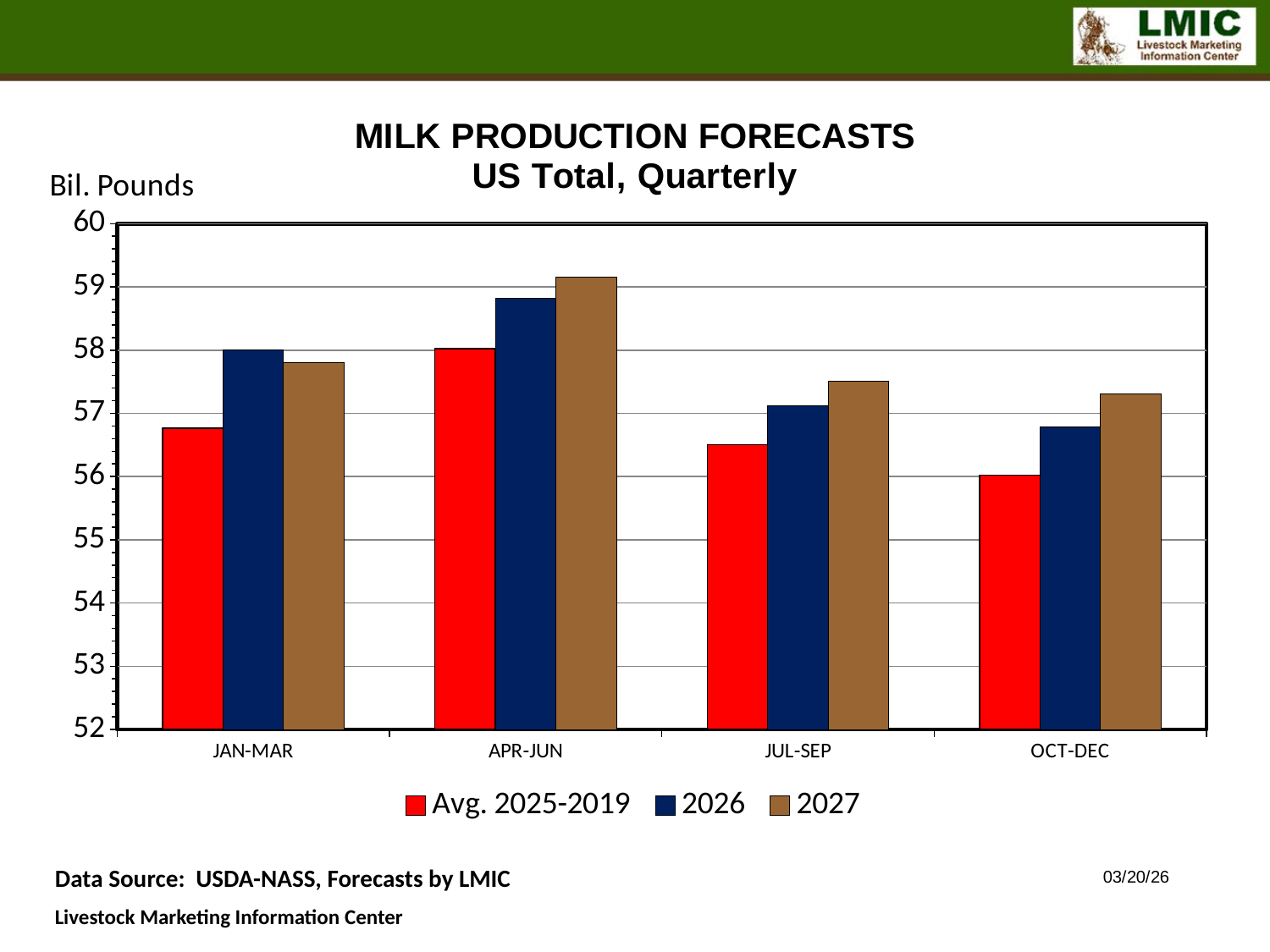
Is the 2026 value for OCT-DEC greater or less than 57? less Does the Avg. 2025-2019 series rise or fall from APR-JUN to OCT-DEC? fall What kind of chart is shown on the slide? bar chart How many series does the legend list? 3 Is the 2027 value for JUL-SEP greater or less than 57? greater Is the 2027 value for APR-JUN greater or less than 58? greater Which quarter has the lowest Avg. 2025-2019 value? OCT-DEC What unit is shown on the y axis label? Bil. Pounds Which quarter has the highest 2027 value? APR-JUN For APR-JUN, which is larger: the 2026 value or the 2027 value? 2027 How many quarters (categories) are shown on the x axis? 4